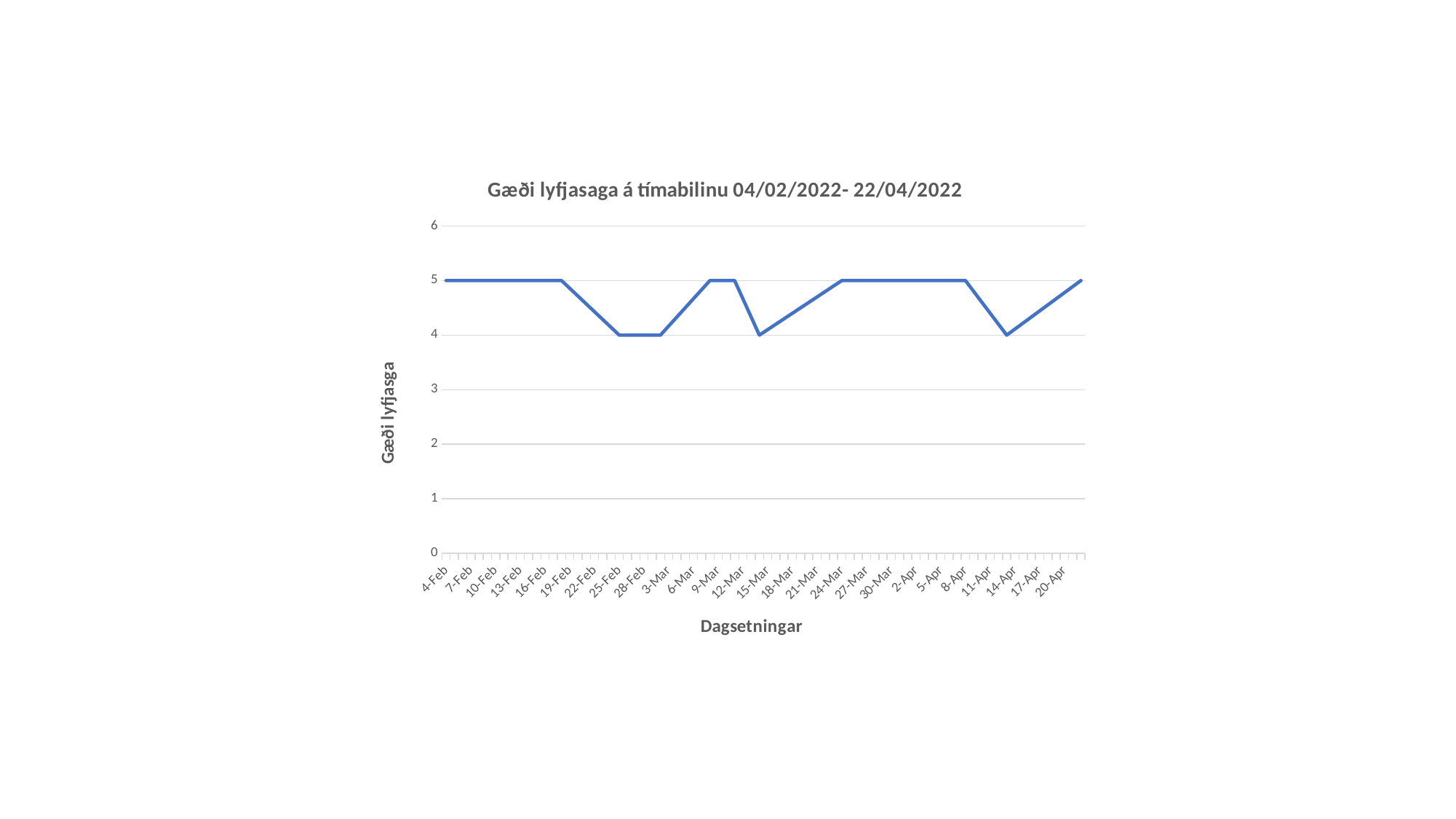
What is the value on 9-Mar? 5 What is the value on 25-Feb? 4 Which is larger, the value on 24-Mar or the value on 15-Mar? 24-Mar What is the title of the chart? Gæði lyfjasaga á tímabilinu 04/02/2022- 22/04/2022 What is the lowest value reached by the line? 4 What is the label of the x axis? Dagsetningar What is the value on 4-Feb? 5 What is the highest value reached by the line? 5 What kind of chart is shown on the slide? line chart